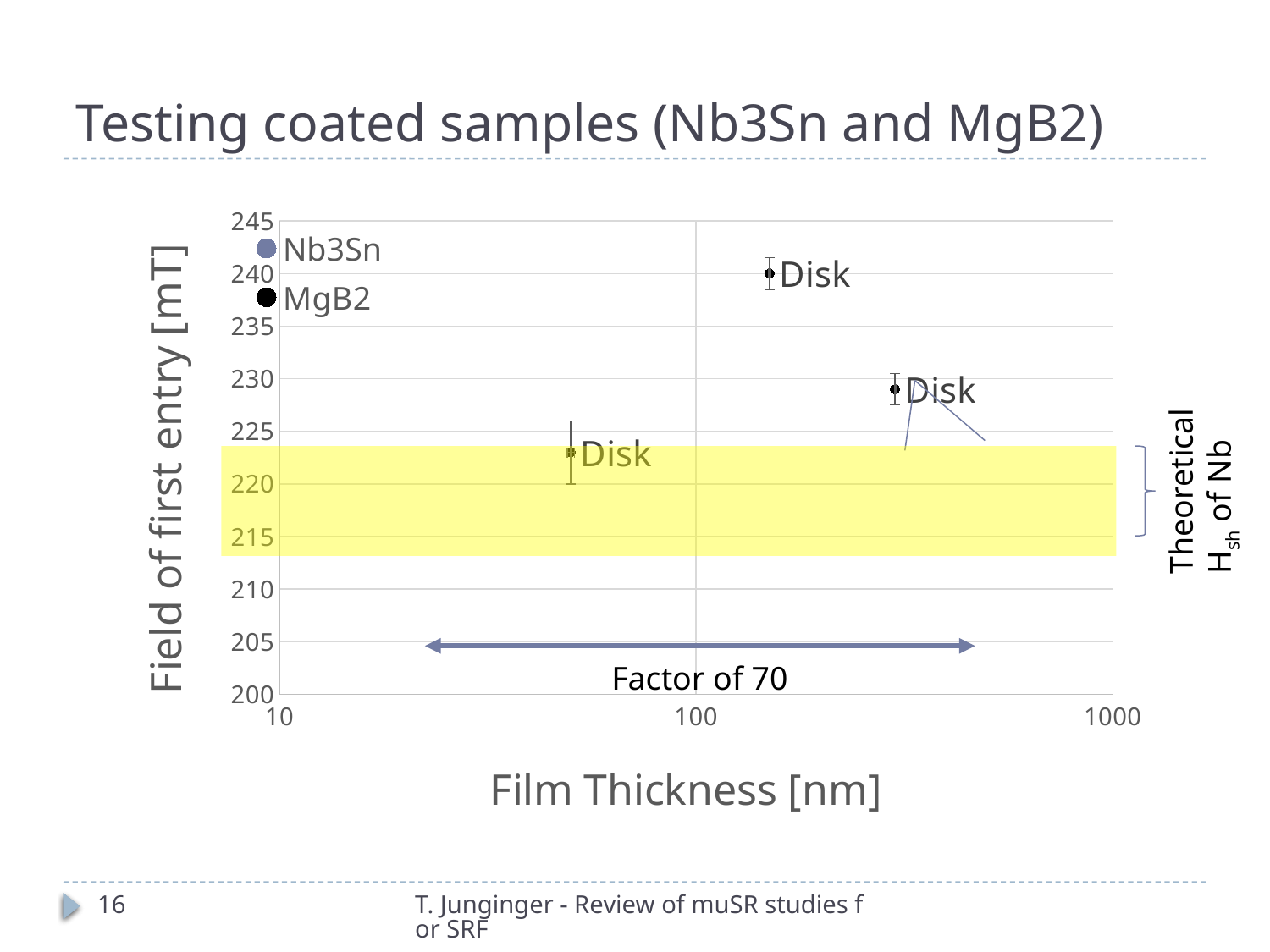
Which of the three Disk points has the lowest field of first entry: the one near 50 nm, near 150 nm, or near 300 nm film thickness? the one near 50 nm Is the field of first entry for the Disk point near 50 nm film thickness greater or less than 230 mT? less What is the label of the chart's x axis? Film Thickness [nm] Which of the three Disk points has the highest field of first entry: the one near 50 nm, near 150 nm, or near 300 nm film thickness? the one near 150 nm How many data points labelled "Disk" are plotted on the chart? 3 What kind of chart is shown on the slide? scatter chart Which has a larger field of first entry: the Disk point near 300 nm or the Disk point near 50 nm film thickness? the Disk point near 300 nm What are the two entries in the chart legend? Nb3Sn and MgB2 How many series does the chart legend list? 2 Is the field of first entry for the Disk point near 150 nm film thickness greater or less than 235 mT? greater Is the field of first entry for the Disk point near 300 nm film thickness greater or less than 235 mT? less